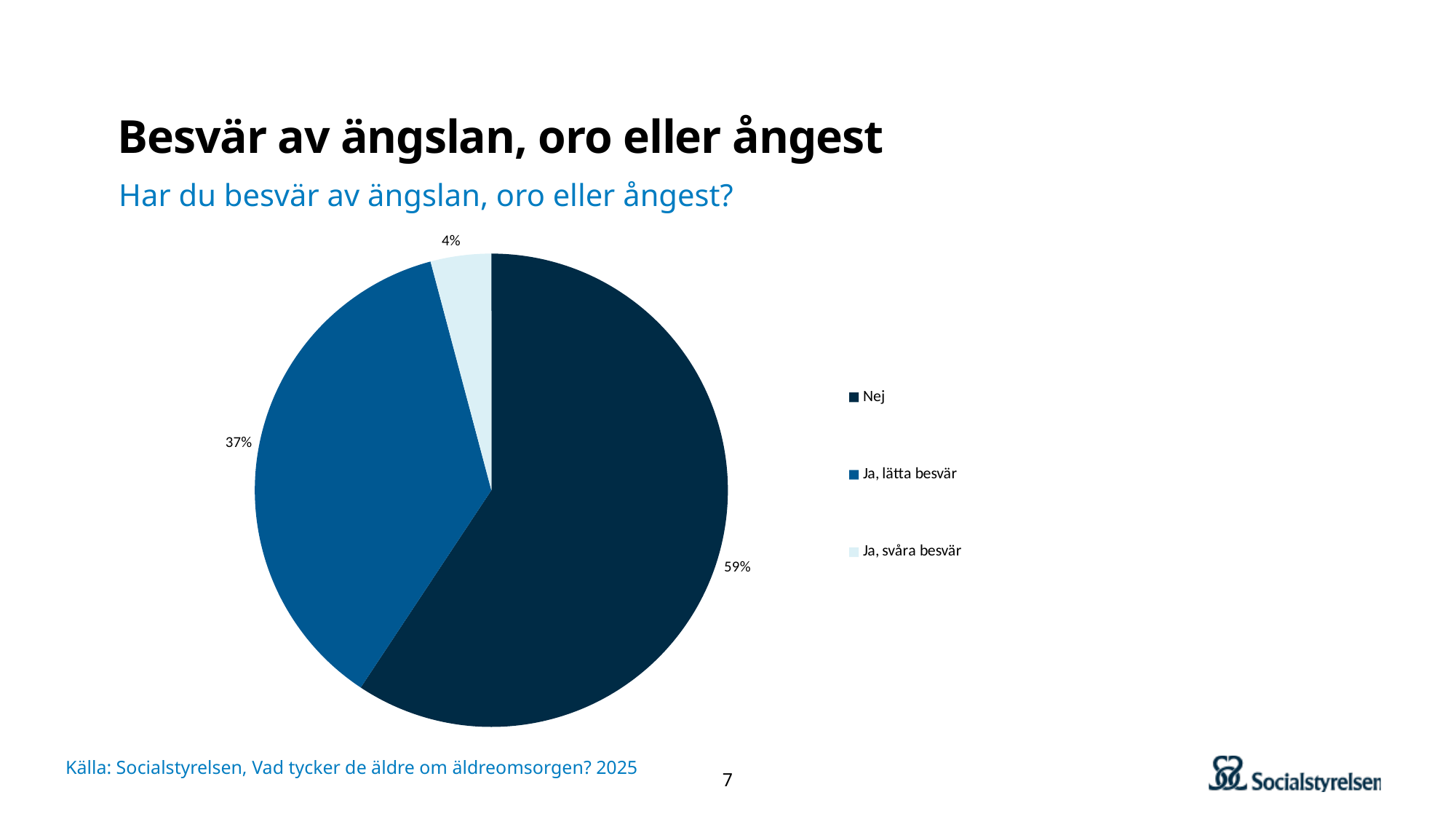
What is the difference in percentage points between "Nej" and "Ja, lätta besvär"? 22 Which category has the largest slice of the pie? Nej What share of the pie is labelled "Ja, lätta besvär"? 37% Which category has the smallest slice of the pie? Ja, svåra besvär What kind of chart is shown on the slide? Pie chart How many categories does the pie chart have? 3 Which is larger, the slice for "Ja, lätta besvär" or the slice for "Ja, svåra besvär"? Ja, lätta besvär What share of the pie is labelled "Ja, svåra besvär"? 4% What is the difference in percentage points between "Ja, lätta besvär" and "Ja, svåra besvär"? 33 Which legend entry is shown in the lightest colour? Ja, svåra besvär What question is shown as the chart's subtitle? Har du besvär av ängslan, oro eller ångest? What share of the pie is labelled "Nej"? 59%